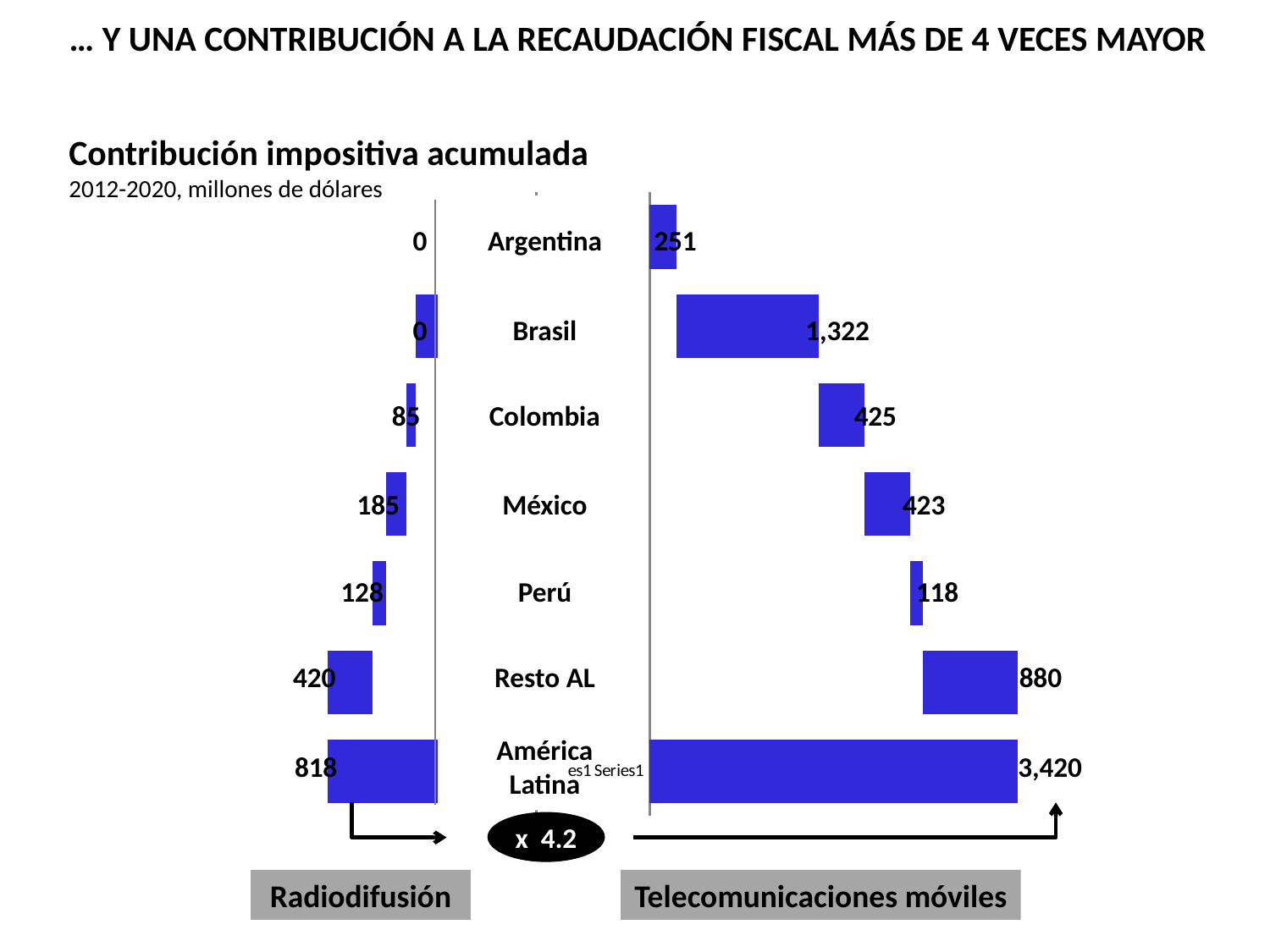
Among the individual countries, which has the lowest Telecomunicaciones móviles value? Perú Among the individual countries (excluding Resto AL and América Latina), which has the highest Telecomunicaciones móviles value? Brasil What type of chart is shown on the slide? Bar chart What is the Radiodifusión value for México? 185 How many row categories are shown in the chart? 7 What is the Telecomunicaciones móviles value for Brasil? 1,322 What is the Radiodifusión value for América Latina? 818 Which is larger for Perú: the Radiodifusión value or the Telecomunicaciones móviles value? Radiodifusión What is the title of the chart? Contribución impositiva acumulada What is the difference between the Telecomunicaciones móviles and Radiodifusión values for América Latina? 2,602 What is the difference between the Telecomunicaciones móviles values for Brasil and Argentina? 1,071 What is the Telecomunicaciones móviles value for Resto AL? 880